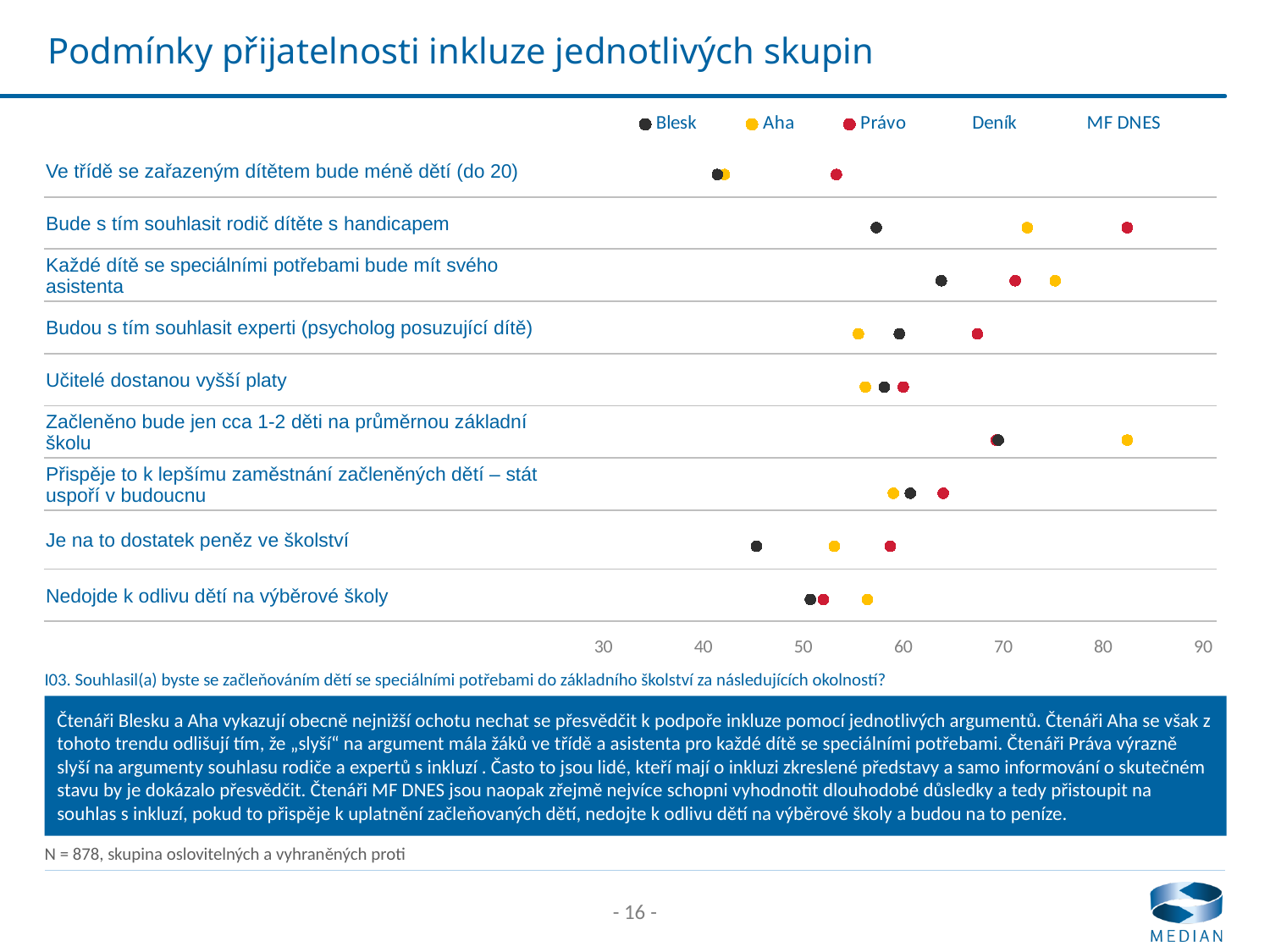
Is the value for Blesk on "Ve třídě se zařazeným dítětem bude méně dětí (do 20)" greater or less than 50? less Is the value for Aha on "Začleněno bude jen cca 1-2 děti na průměrnou základní školu" greater or less than 70? greater On "Je na to dostatek peněz ve školství", which is larger: the value for Blesk or for Právo? Právo What kind of chart is shown on the slide? dot plot Is the value for Blesk on "Je na to dostatek peněz ve školství" greater or less than 50? less How many series does the legend list? 5 On "Bude s tím souhlasit rodič dítěte s handicapem", which is larger: the value for Právo or for Blesk? Právo How many statements (categories) are listed on the chart? 9 What is the title of the chart slide? Podmínky přijatelnosti inkluze jednotlivých skupin